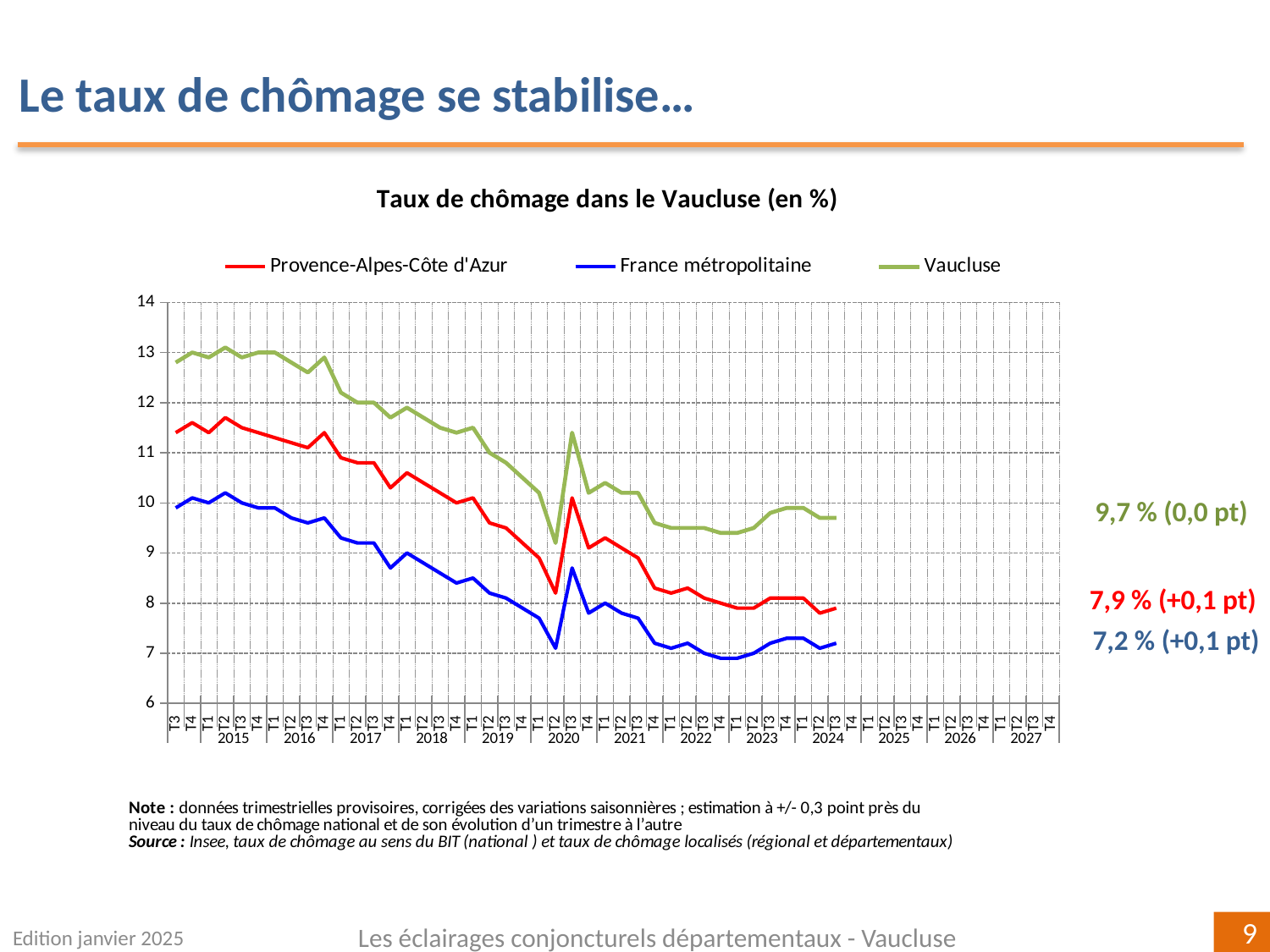
What kind of chart is shown on the slide? line chart Is the Vaucluse value at T3 2014 greater or less than 12? greater What is the latest unemployment rate shown for Provence-Alpes-Côte d'Azur? 7,9 % What is the difference between the latest Vaucluse rate and the latest France métropolitaine rate? 2,5 points What quarterly change is annotated for the Vaucluse series? 0,0 pt Which series has the lowest values across the whole period? France métropolitaine How many series does the legend list? 3 What is the latest unemployment rate shown for Vaucluse? 9,7 % What is the latest unemployment rate shown for France métropolitaine? 7,2 % Which series has the highest values across the whole period? Vaucluse What is the title of the chart? Taux de chômage dans le Vaucluse (en %) Does the Vaucluse unemployment rate rise or fall overall between 2015 and 2024? fall